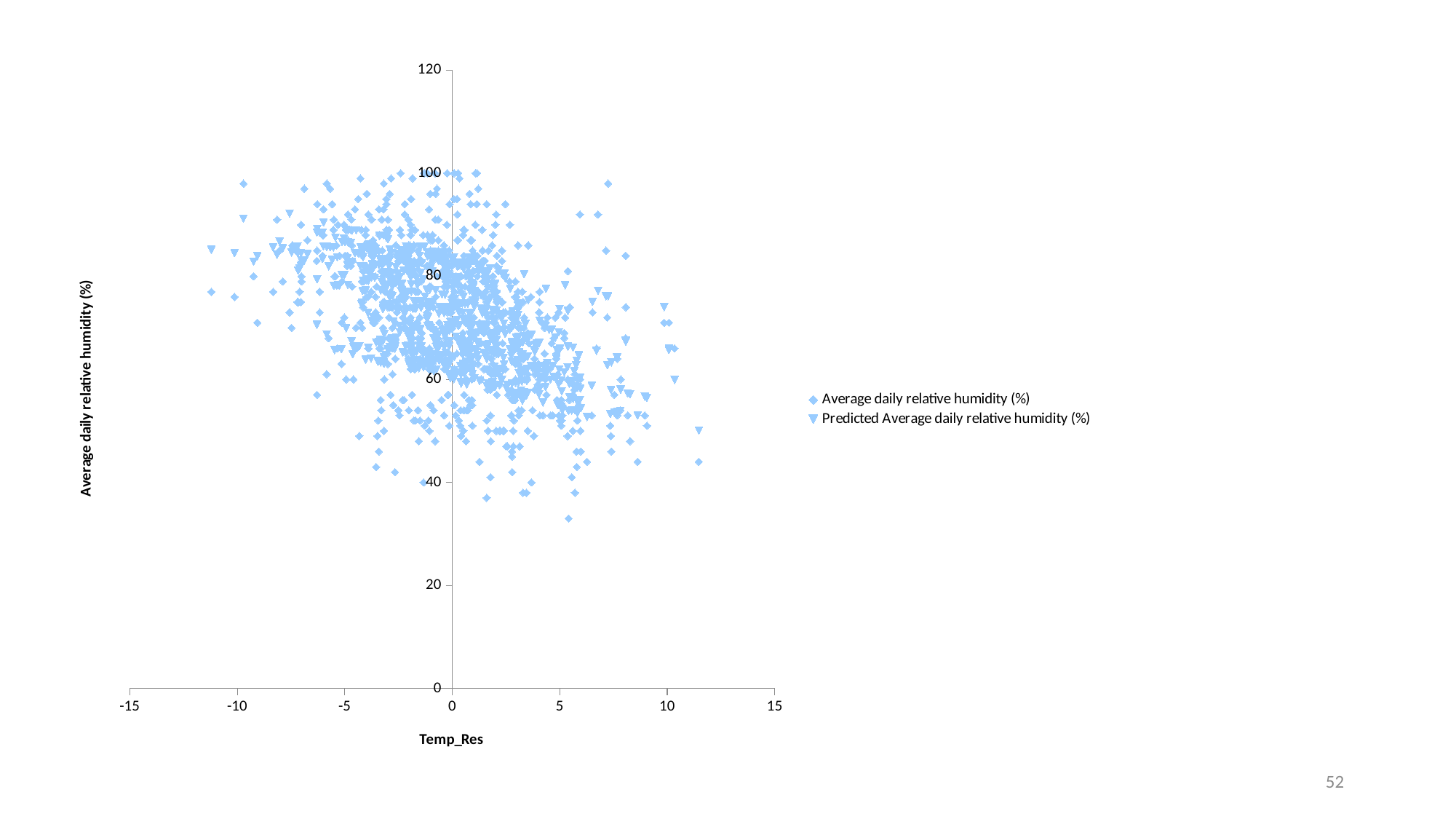
As Temp_Res increases along the x axis, do the humidity values generally rise or fall? Fall What is the title of the x axis? Temp_Res How many series does the legend list? 2 What is the second series listed in the legend? Predicted Average daily relative humidity (%) What kind of chart is shown on the slide? Scatter chart